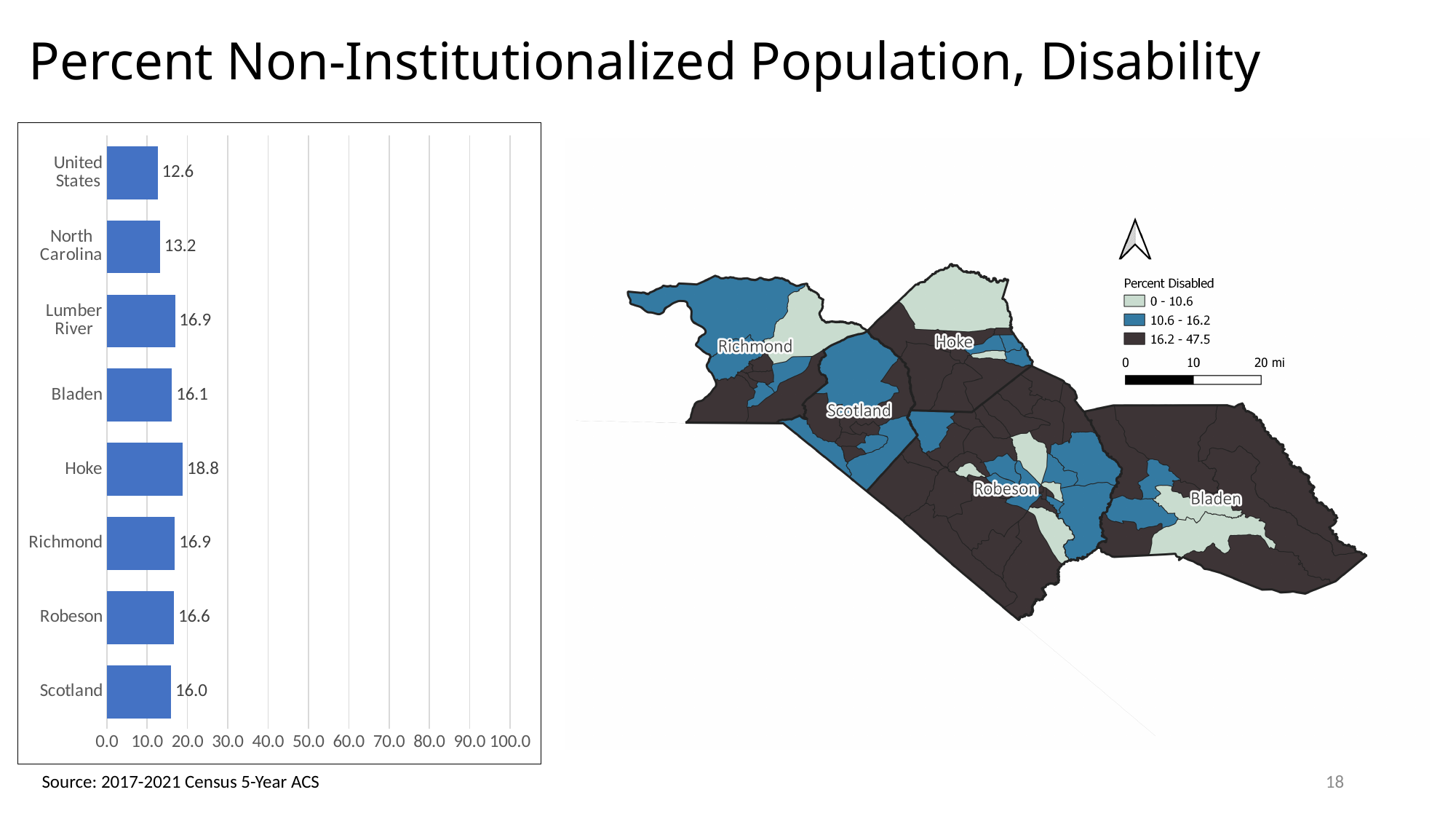
Which category has the lowest value in the bar chart? United States What is the value for the United States in the bar chart? 12.6 Is the value for Lumber River in the bar chart greater or less than 20.0? less What is the difference between the values for Hoke and North Carolina in the bar chart? 5.6 Which is larger in the bar chart, the value for Robeson or the value for Bladen? Robeson How many categories are shown in the bar chart? 8 What is the title of the map legend on the right of the slide? Percent Disabled What kind of chart is shown on the left of the slide? bar chart What is the value for Hoke in the bar chart? 18.8 Which category has the highest value in the bar chart? Hoke What is the highest value shown on the x axis of the bar chart? 100.0 What is the value for Scotland in the bar chart? 16.0